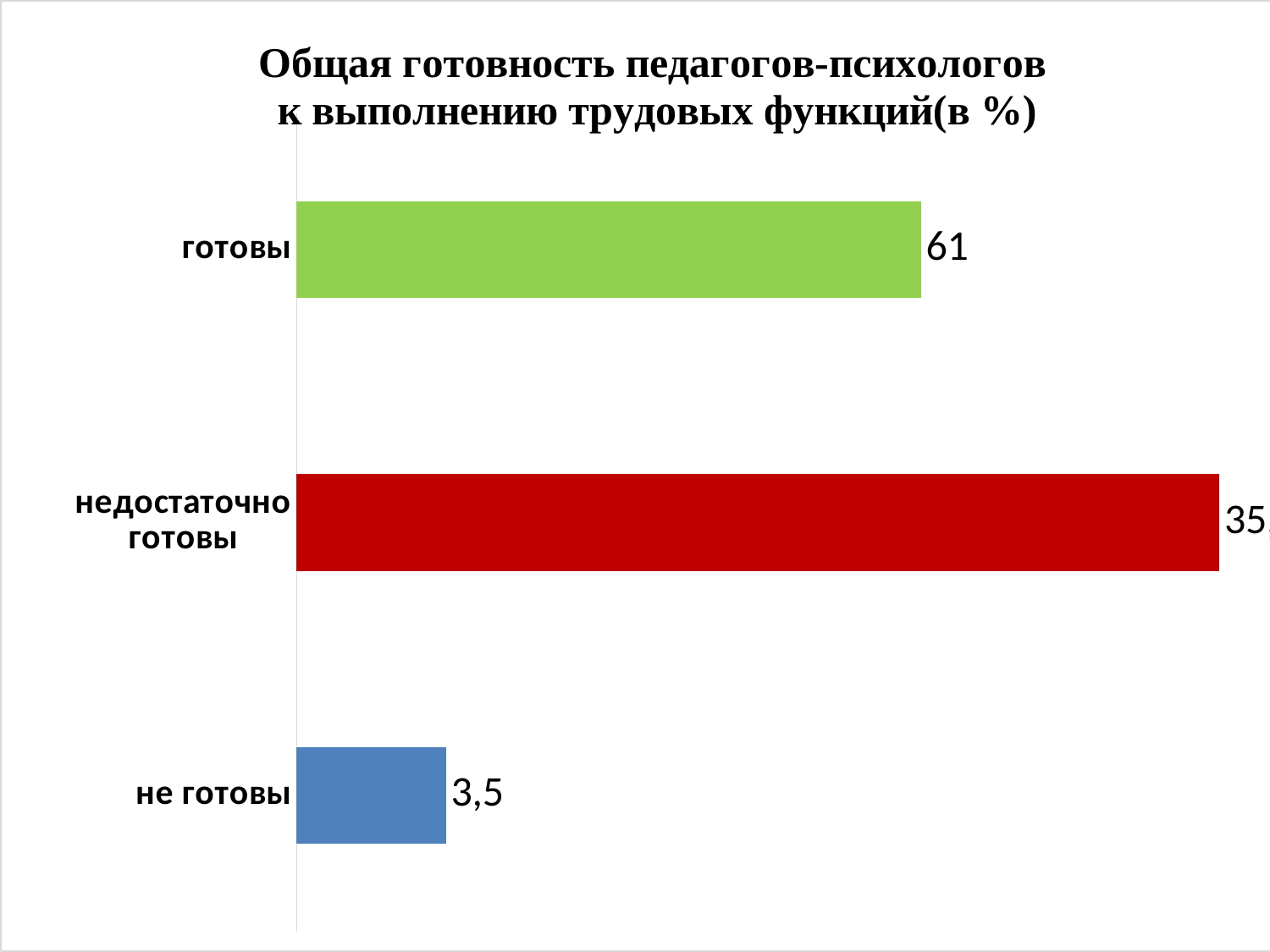
How many categories are shown in the chart? 3 What colour is the bar for "готовы"? green What colour is the bar for "недостаточно готовы"? red What is the value for "готовы"? 61 What type of chart is shown on the slide? bar chart What is the value for "не готовы"? 3,5 What is the difference between the values for "готовы" and "не готовы"? 57,5 Which is larger, the value for "готовы" or the value for "не готовы"? готовы Which category has the lowest value? не готовы